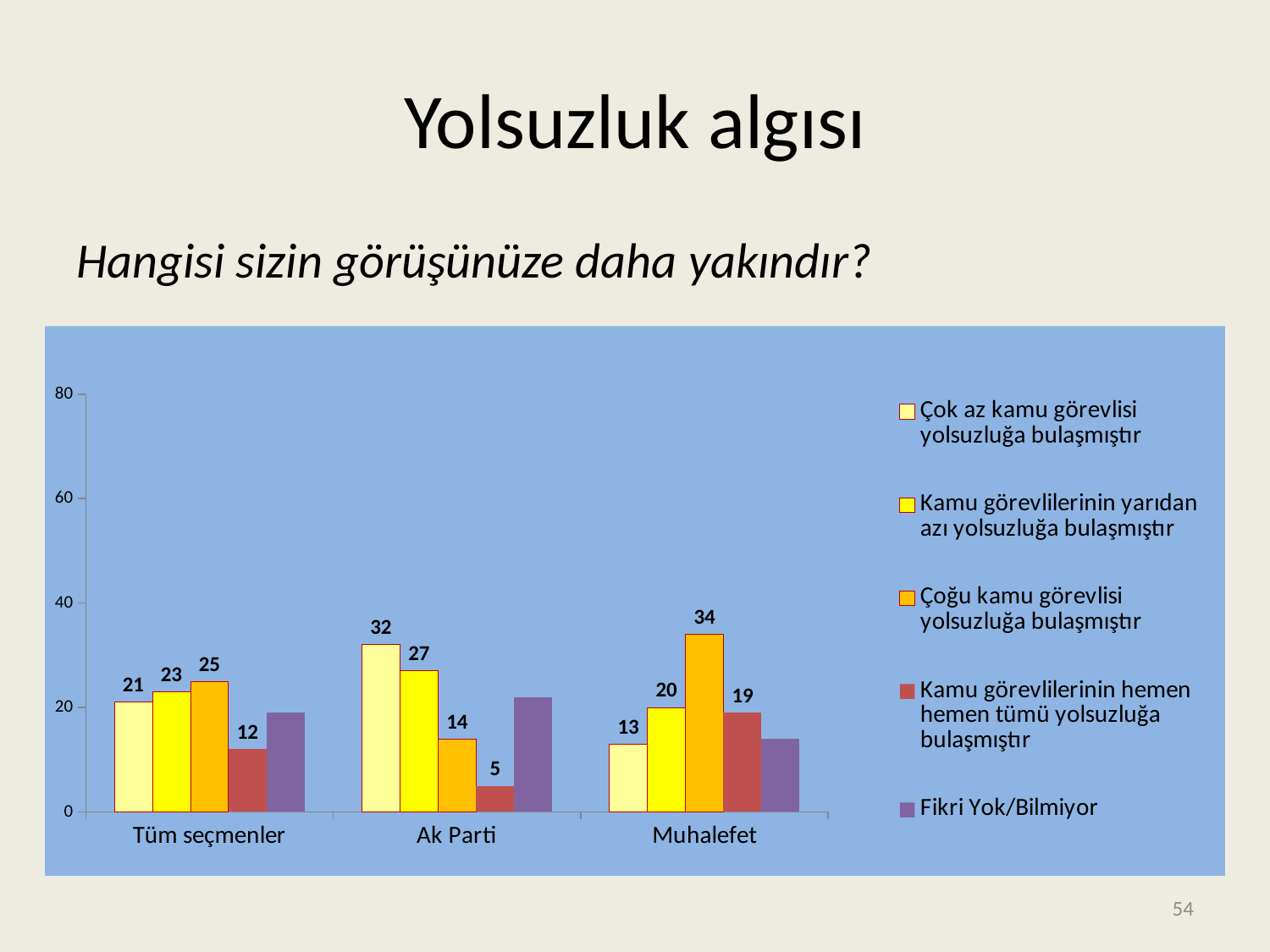
Which is larger: 'Kamu görevlilerinin yarıdan azı yolsuzluğa bulaşmıştır' for Ak Parti or for Muhalefet? Ak Parti What is the difference between the 'Çok az kamu görevlisi yolsuzluğa bulaşmıştır' values for Ak Parti and Muhalefet? 19 Is the value for 'Fikri Yok/Bilmiyor' in the Ak Parti group greater or less than 20? greater What type of chart is shown on the slide? bar chart What is the title of the slide containing the chart? Yolsuzluk algısı Which group has the lowest value for 'Kamu görevlilerinin hemen hemen tümü yolsuzluğa bulaşmıştır'? Ak Parti How many series does the legend list? 5 What is the value for 'Çoğu kamu görevlisi yolsuzluğa bulaşmıştır' in the Muhalefet group? 34 What is the value for 'Kamu görevlilerinin hemen hemen tümü yolsuzluğa bulaşmıştır' in the Tüm seçmenler group? 12 How many categories are shown on the x axis? 3 Which group has the highest value for 'Çoğu kamu görevlisi yolsuzluğa bulaşmıştır'? Muhalefet What is the value for 'Çok az kamu görevlisi yolsuzluğa bulaşmıştır' in the Ak Parti group? 32